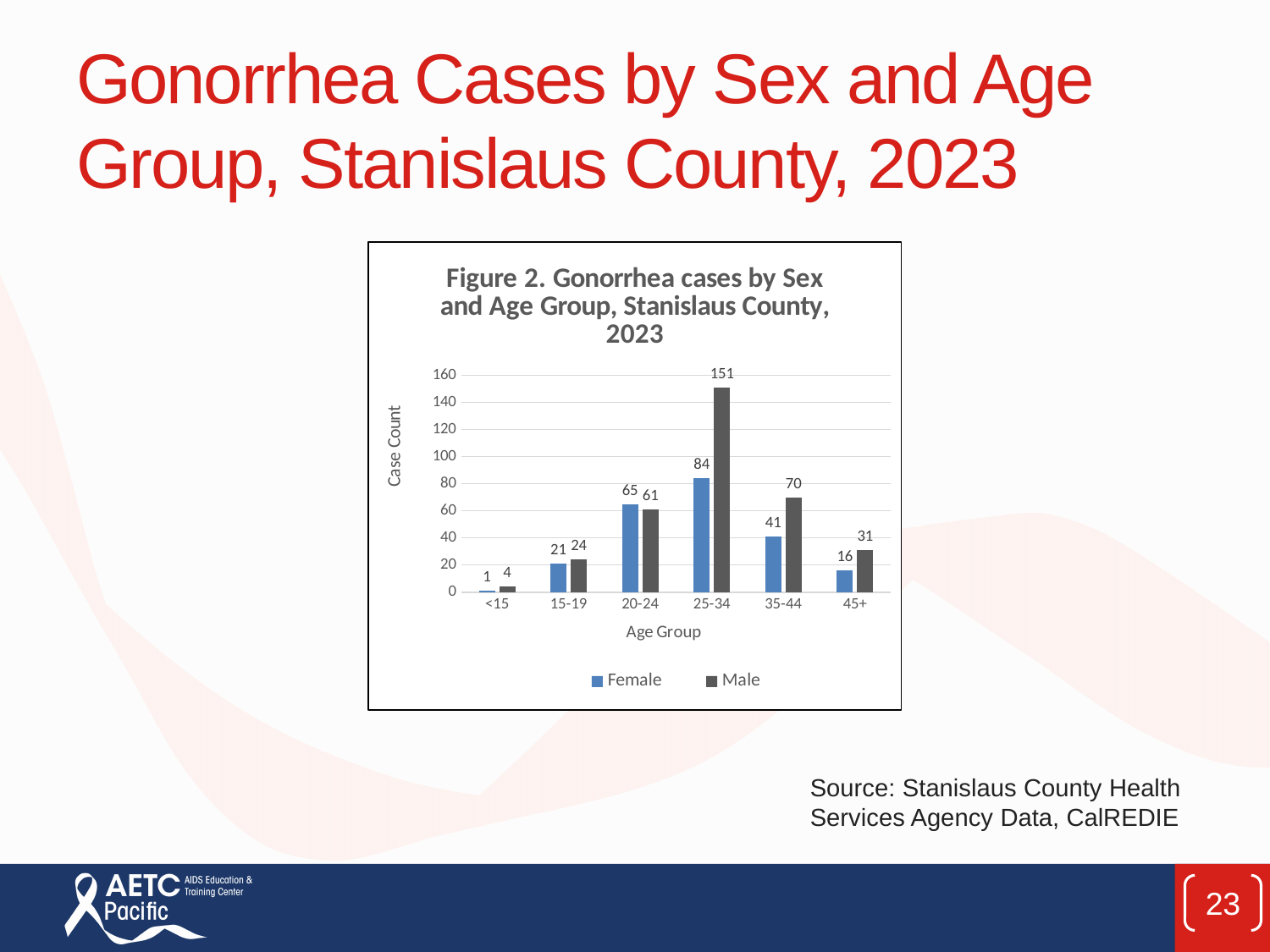
How many age groups are shown on the x axis? 6 How many series does the legend list? 2 Which age group has the highest Male case count? 25-34 What is the Male case count for the 25-34 age group? 151 Is the Male case count for the 35-44 age group greater or less than 60? greater What is the Female case count for the 20-24 age group? 65 Which age group has the lowest Female case count? <15 What is the label of the y axis? Case Count What is the Female case count for the 45+ age group? 16 What kind of chart is shown? Bar chart What is the difference between the Male and Female case counts for the 25-34 age group? 67 Which is larger for the 20-24 age group, the Female or the Male case count? Female